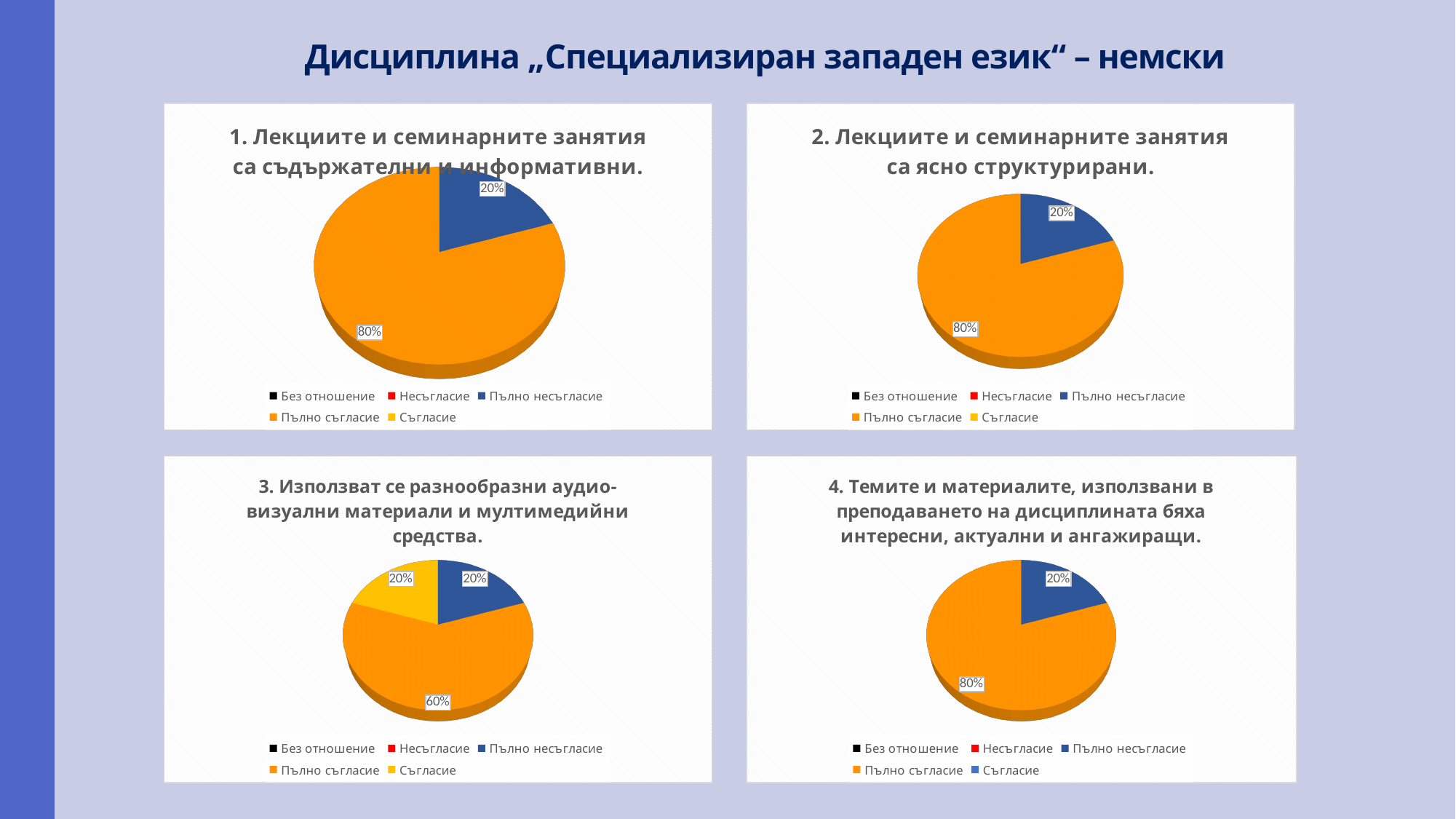
In the top-right chart ("2. Лекциите и семинарните занятия са ясно структурирани."), which category has the largest slice? Пълно съгласие What type of chart is used in the top-left chart ("1. Лекциите и семинарните занятия са съдържателни и информативни.")? Pie chart In the bottom-left chart ("3. Използват се разнообразни аудио-визуални материали и мултимедийни средства."), what share of the pie is "Пълно съгласие"? 60% In the top-right chart ("2. Лекциите и семинарните занятия са ясно структурирани."), what is the value of the "Пълно несъгласие" slice? 20% In the bottom-left chart ("3. Използват се разнообразни аудио-визуални материали и мултимедийни средства."), what is the value of the "Съгласие" slice? 20% How many entries does the legend of the top-right chart ("2. Лекциите и семинарните занятия са ясно структурирани.") list? 5 In the bottom-left chart ("3. Използват се разнообразни аудио-визуални материали и мултимедийни средства."), what is the difference between the "Пълно съгласие" slice and the "Съгласие" slice? 40% In the bottom-left chart ("3. Използват се разнообразни аудио-визуални материали и мултимедийни средства."), how many slices does the pie have? 3 In the top-left chart ("1. Лекциите и семинарните занятия са съдържателни и информативни."), what share of the pie is "Пълно несъгласие"? 20% In the top-left chart ("1. Лекциите и семинарните занятия са съдържателни и информативни."), what share of the pie is "Пълно съгласие"? 80% In the bottom-right chart ("4. Темите и материалите, използвани в преподаването на дисциплината бяха интересни, актуални и ангажиращи."), which is larger, "Пълно съгласие" or "Пълно несъгласие"? Пълно съгласие